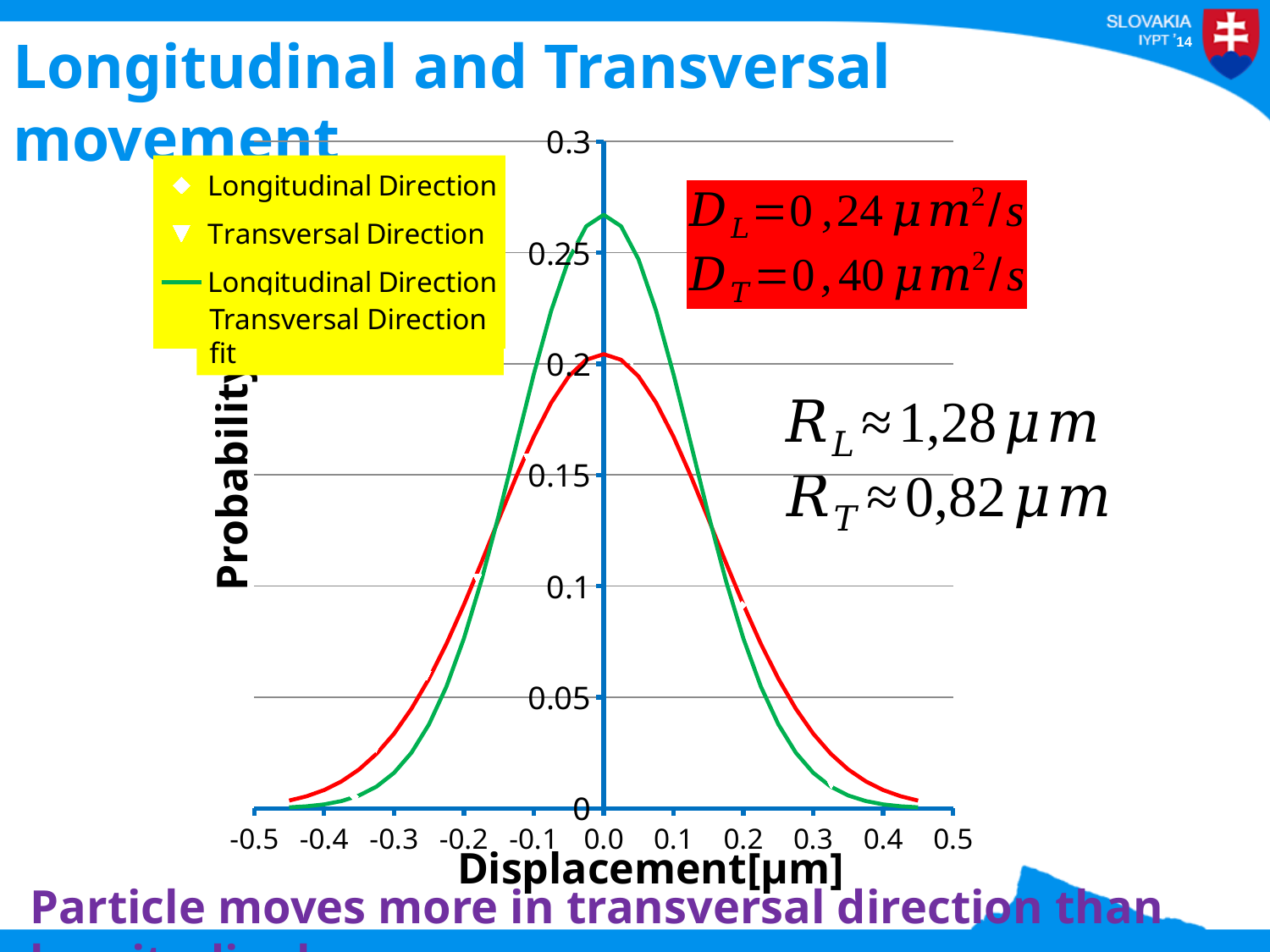
How do the curve values change as displacement increases from 0.0 to 0.5? they fall What kind of chart is shown on the slide? line chart At displacement 0.4, which curve has the larger value, the green curve or the red curve? red curve Is the value of the red curve at displacement -0.1 greater or less than 0.15? greater How do the curve values change as displacement increases from -0.5 to 0.0? they rise Is the peak value of the green (Longitudinal Direction) curve at displacement 0.0 greater or less than 0.25? greater What is the title of the y axis of the chart? Probability How many entries does the chart legend list? 4 Is the value of the green curve at displacement 0.3 greater or less than 0.1? less Which curve reaches a higher peak at displacement 0.0, the green Longitudinal Direction curve or the red Transversal Direction fit curve? green Longitudinal Direction curve What is the title of the x axis of the chart? Displacement[μm]